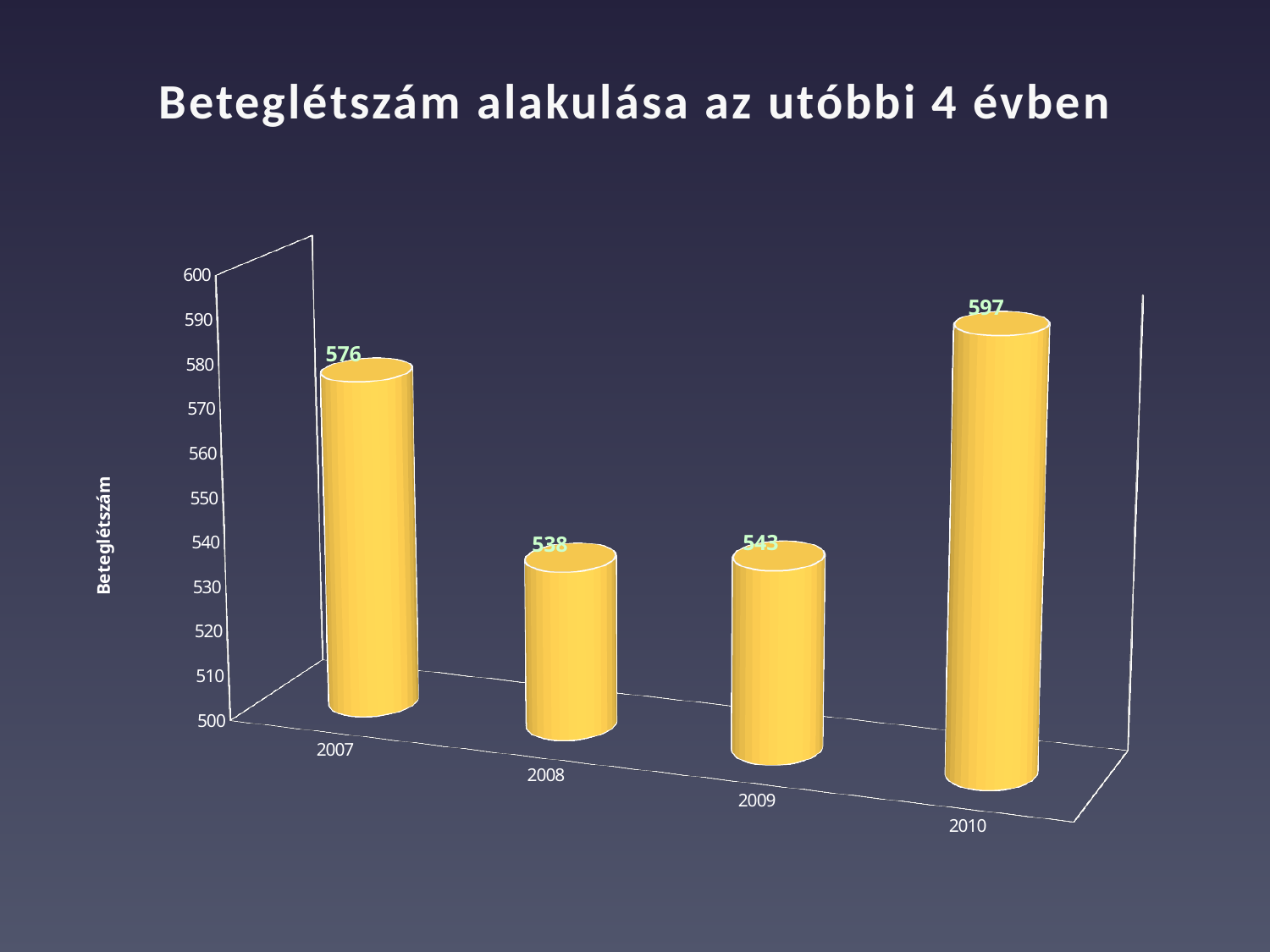
Which year has the lowest value? 2008 What is the value for 2010? 597 What is the difference between the values for 2009 and 2008? 5 What is the title of the chart? Beteglétszám alakulása az utóbbi 4 évben Which is larger, the value for 2007 or the value for 2009? 2007 What is the value for 2007? 576 What is the value for 2008? 538 Which year has the highest value? 2010 What is the difference between the values for 2010 and 2007? 21 How many years are shown on the chart? 4 What kind of chart is this? bar chart What is the value for 2009? 543